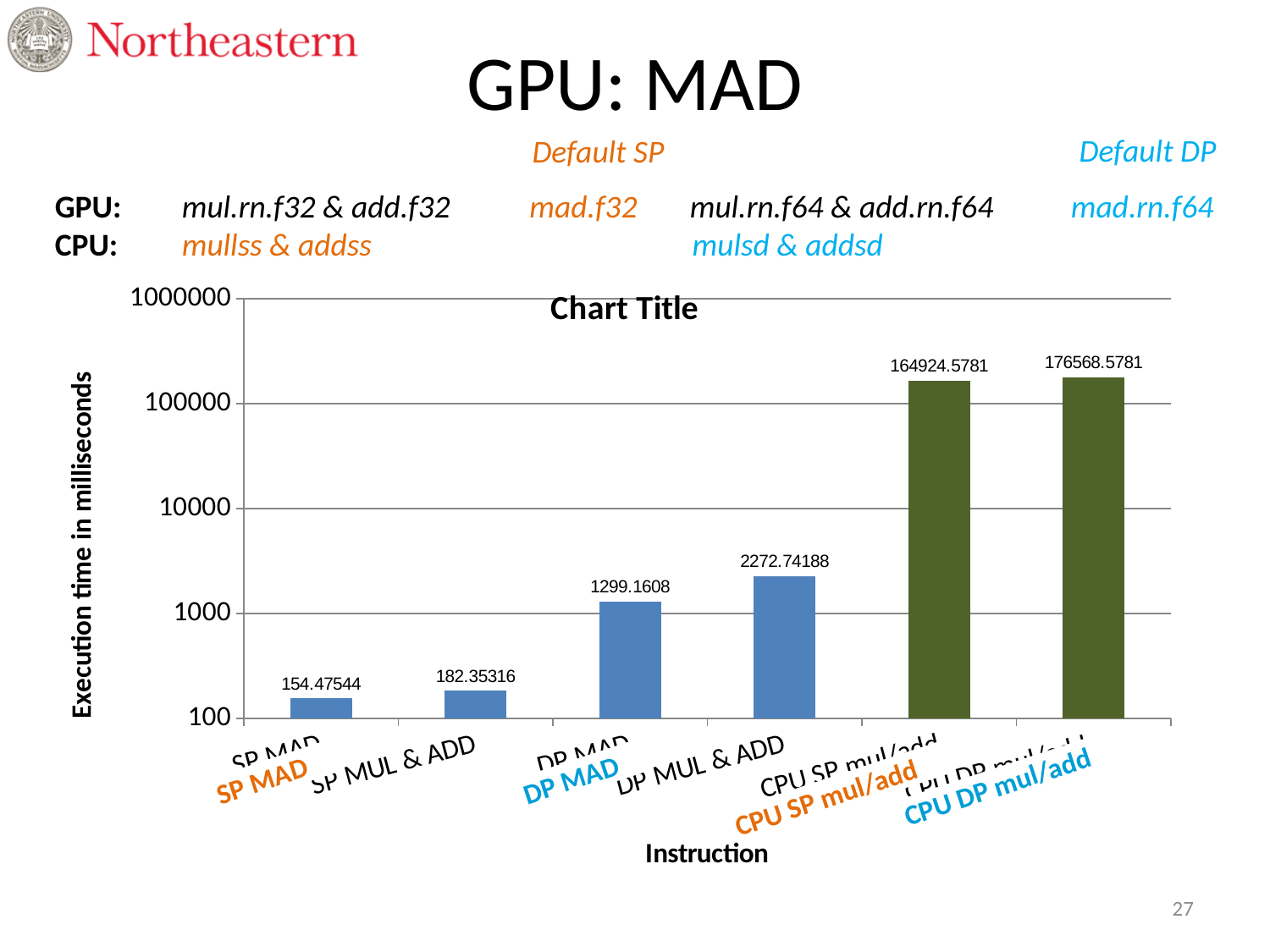
What is the execution time for CPU SP mul/add? 164924.5781 What is the execution time for DP MAD? 1299.1608 Which has a larger execution time, DP MAD or DP MUL & ADD? DP MUL & ADD Which instruction has the lowest execution time? SP MAD What kind of chart is shown on the slide? bar chart What is the execution time for DP MUL & ADD? 2272.74188 What is the difference in execution time between CPU DP mul/add and CPU SP mul/add? 11644 What is the difference in execution time between SP MUL & ADD and SP MAD? 27.87772 Which instruction has the highest execution time? CPU DP mul/add Is the execution time for DP MAD greater or less than 1000? greater How many instructions are plotted on the chart? 6 What is the execution time for SP MAD? 154.47544